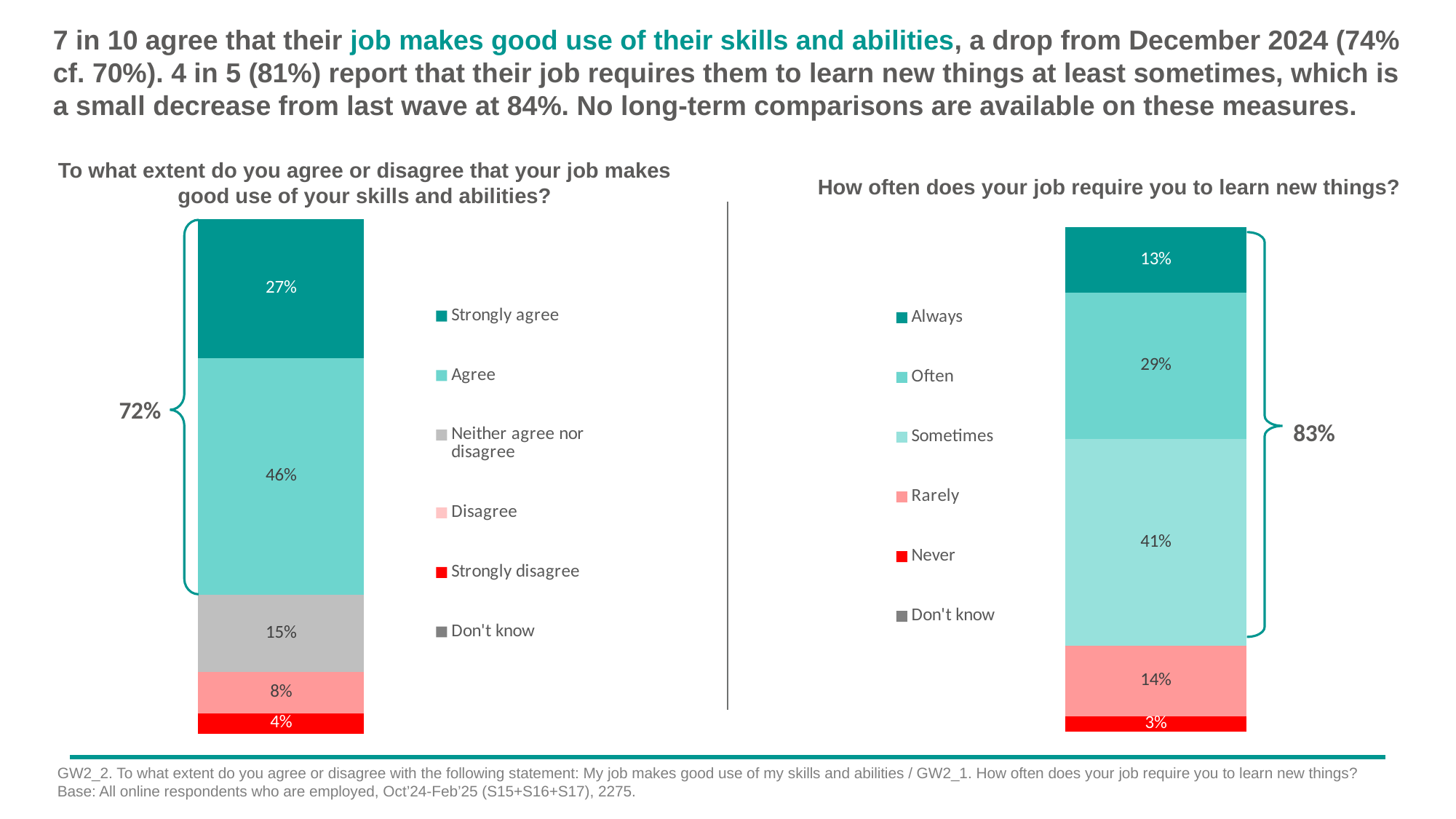
How many entries does the legend of the chart 'How often does your job require you to learn new things?' list? 6 In the chart 'How often does your job require you to learn new things?', which labelled segment has the smallest value? Never In the chart 'To what extent do you agree or disagree that your job makes good use of your skills and abilities?', what percentage is shown for Neither agree nor disagree? 15% In the chart 'To what extent do you agree or disagree that your job makes good use of your skills and abilities?', what percentage is shown for Strongly agree? 27% In the chart 'How often does your job require you to learn new things?', what percentage is shown for Always? 13% In the chart 'To what extent do you agree or disagree that your job makes good use of your skills and abilities?', what is the difference between the Agree and Strongly agree percentages? 19% In the chart 'How often does your job require you to learn new things?', what percentage is shown for Sometimes? 41% In the chart 'How often does your job require you to learn new things?', which is larger, Often or Rarely? Often In the chart 'To what extent do you agree or disagree that your job makes good use of your skills and abilities?', what percentage is shown for Agree? 46% In the chart 'To what extent do you agree or disagree that your job makes good use of your skills and abilities?', which labelled segment has the largest value? Agree In the chart 'To what extent do you agree or disagree that your job makes good use of your skills and abilities?', what combined percentage does the bracket show for Strongly agree and Agree? 72% In the chart 'How often does your job require you to learn new things?', what combined percentage does the bracket show for Always, Often and Sometimes? 83%